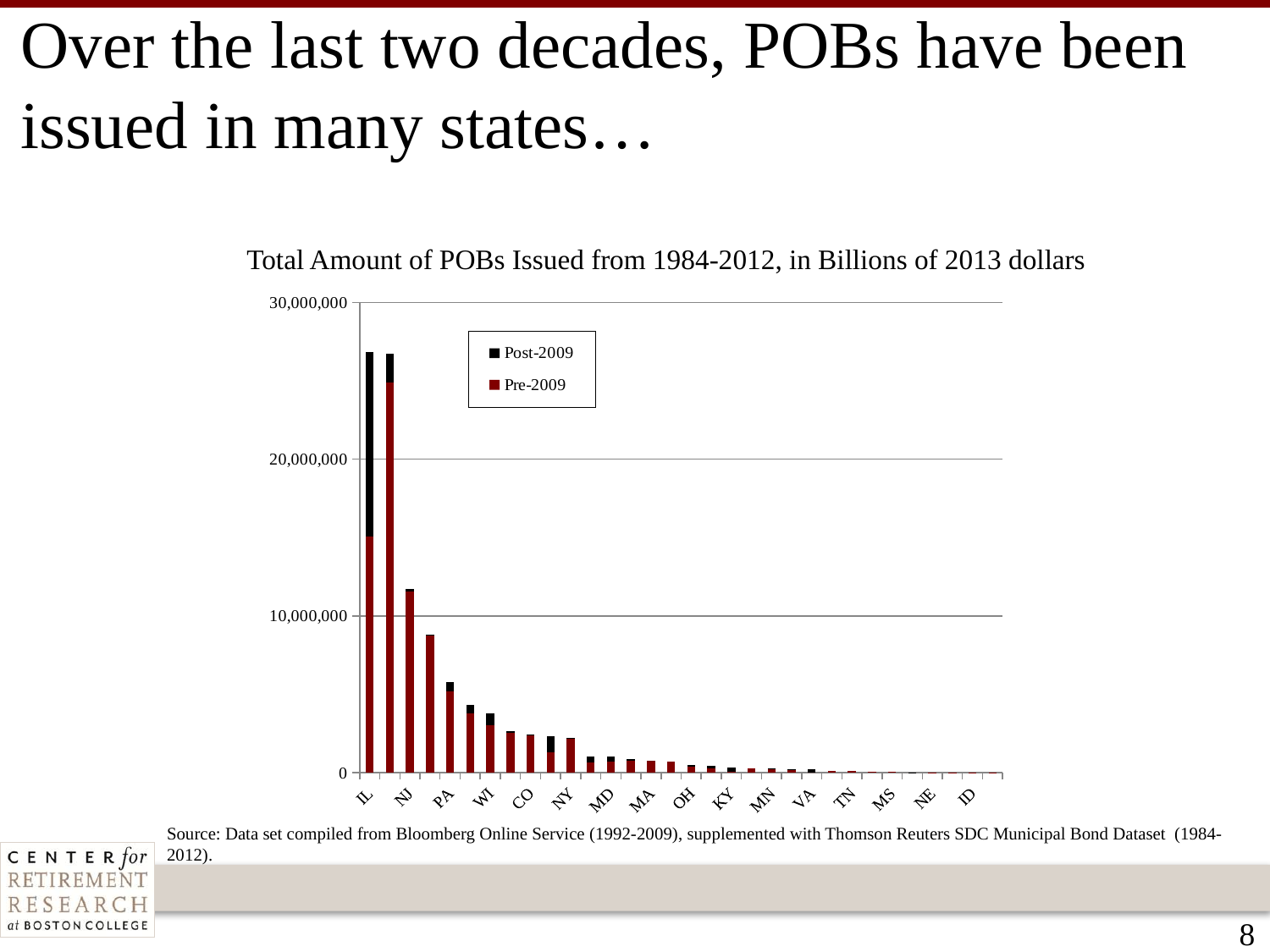
How many series does the legend list? 2 Is the total value for IL greater or less than 20,000,000? greater Is the total value for ID greater or less than 10,000,000? less Is the total value for WI greater or less than 10,000,000? less Do the bar totals rise or fall moving from left to right along the x axis? fall Which state has the larger total bar, IL or PA? IL Which two series are listed in the chart legend? Post-2009 and Pre-2009 Which state has the larger total bar, NJ or WI? NJ What kind of chart is shown on the slide? Stacked bar chart What is the title of the chart? Total Amount of POBs Issued from 1984-2012, in Billions of 2013 dollars